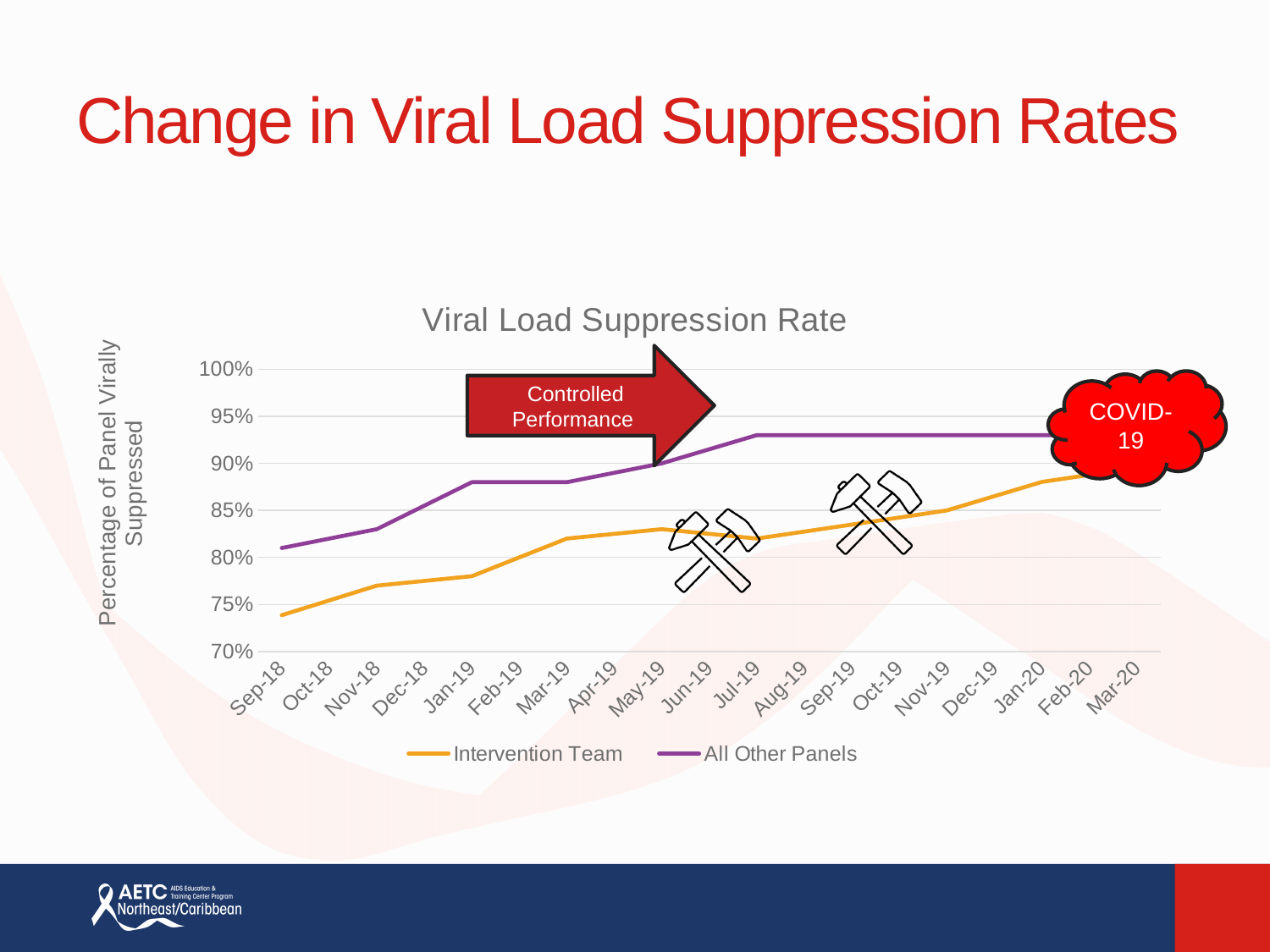
How many series does the legend list? 2 Is the value for All Other Panels in Sep-18 greater or less than 85%? less Is the value for Intervention Team in Nov-18 greater or less than 80%? less Is the value for Intervention Team in Sep-18 greater or less than 80%? less Which series has the higher value in Sep-18, Intervention Team or All Other Panels? All Other Panels Does the Intervention Team line generally rise or fall from Sep-18 to Feb-20? Rise What is the title of the chart? Viral Load Suppression Rate How many months are shown along the x axis? 19 What kind of chart is shown on the slide? Line chart What colour is the Intervention Team line? Orange